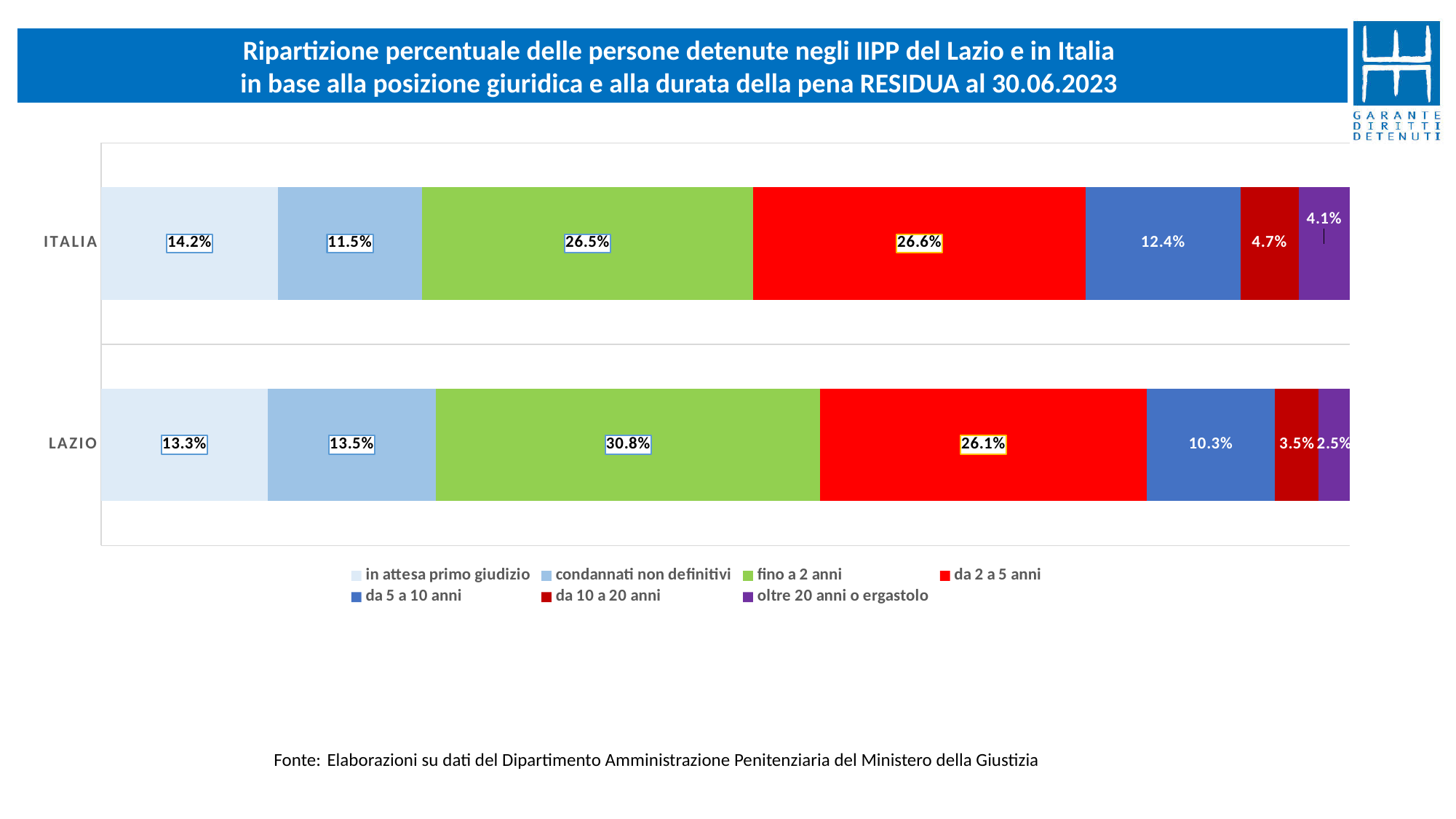
Which series has the highest value for LAZIO? fino a 2 anni Which series is shown in green in the chart? fino a 2 anni How many series does the legend list? 7 What is the value for 'oltre 20 anni o ergastolo' for LAZIO? 2.5% What is the value for 'da 10 a 20 anni' for ITALIA? 4.7% Which is larger, the 'da 5 a 10 anni' value for ITALIA or for LAZIO? ITALIA What is the value for 'fino a 2 anni' for LAZIO? 30.8% What is the difference between the 'fino a 2 anni' values for LAZIO and ITALIA? 4.3% How many categories (bars) are shown in the chart? 2 What is the value for 'in attesa primo giudizio' for ITALIA? 14.2% Which series has the lowest value for ITALIA? oltre 20 anni o ergastolo What kind of chart is shown on the slide? stacked bar chart